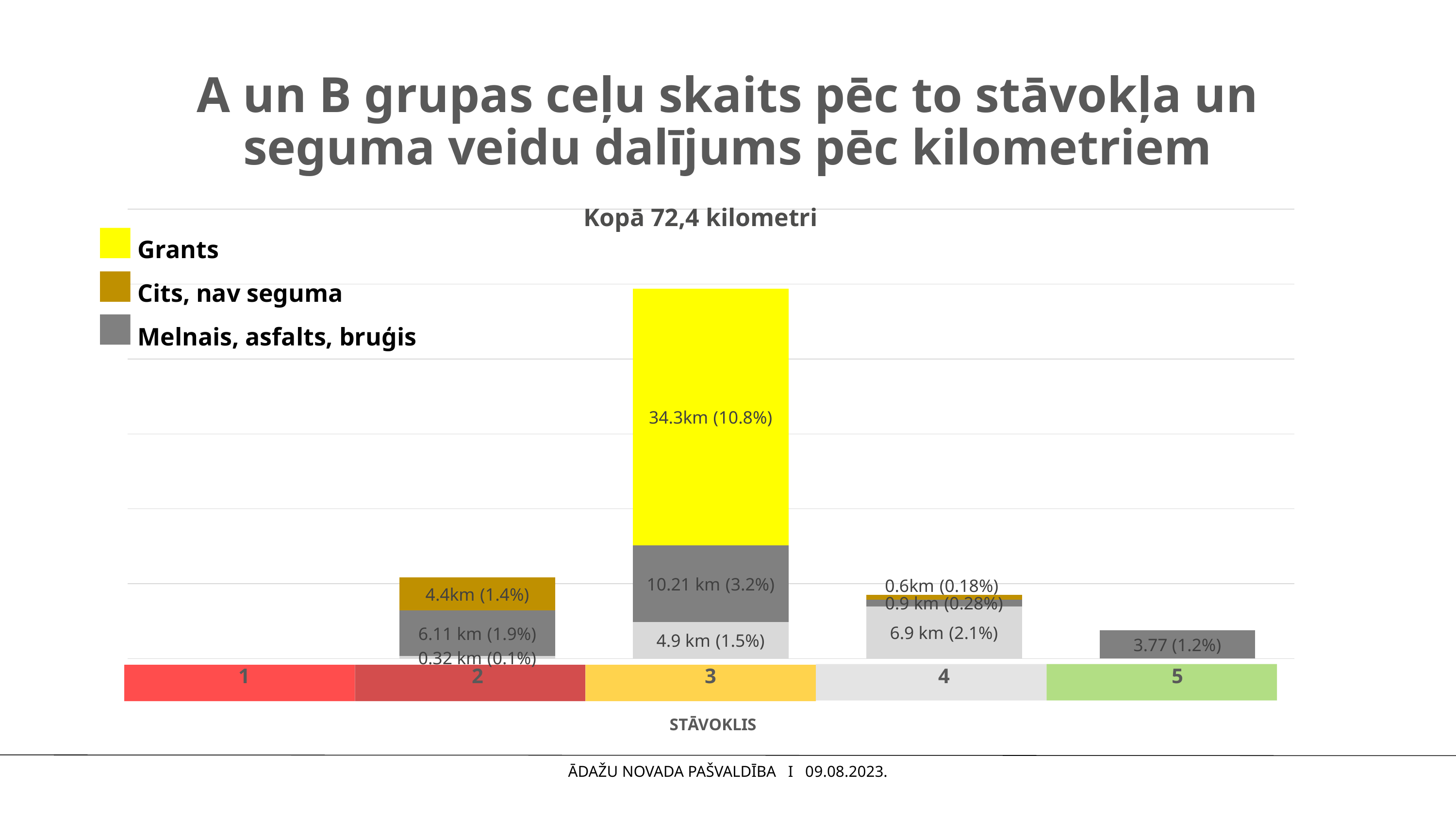
Which is larger for condition 3: the Grants segment or the Melnais, asfalts, bruģis segment? Grants Which condition category has the tallest stacked bar? 3 What is the difference in kilometres between the Grants segment (34.3 km) and the Melnais, asfalts, bruģis segment (10.21 km) for condition 3? 24.09 km What is the value of the Cits, nav seguma segment for condition 4? 0.6km (0.18%) What total length is stated in the subtitle above the chart? Kopā 72,4 kilometri What is the value labelled on the bar for condition 5? 3.77 (1.2%) How many series does the legend list? 3 How many condition categories (STĀVOKLIS) are shown on the x axis? 5 What is the value of the Grants (yellow) segment for condition 3? 34.3km (10.8%) What is the value of the Melnais, asfalts, bruģis (grey) segment for condition 2? 6.11 km (1.9%) What is the total length in kilometres of the stacked bar for condition 4 (0.6 km + 0.9 km + 6.9 km)? 8.4 km What kind of chart is shown on the slide? stacked bar chart